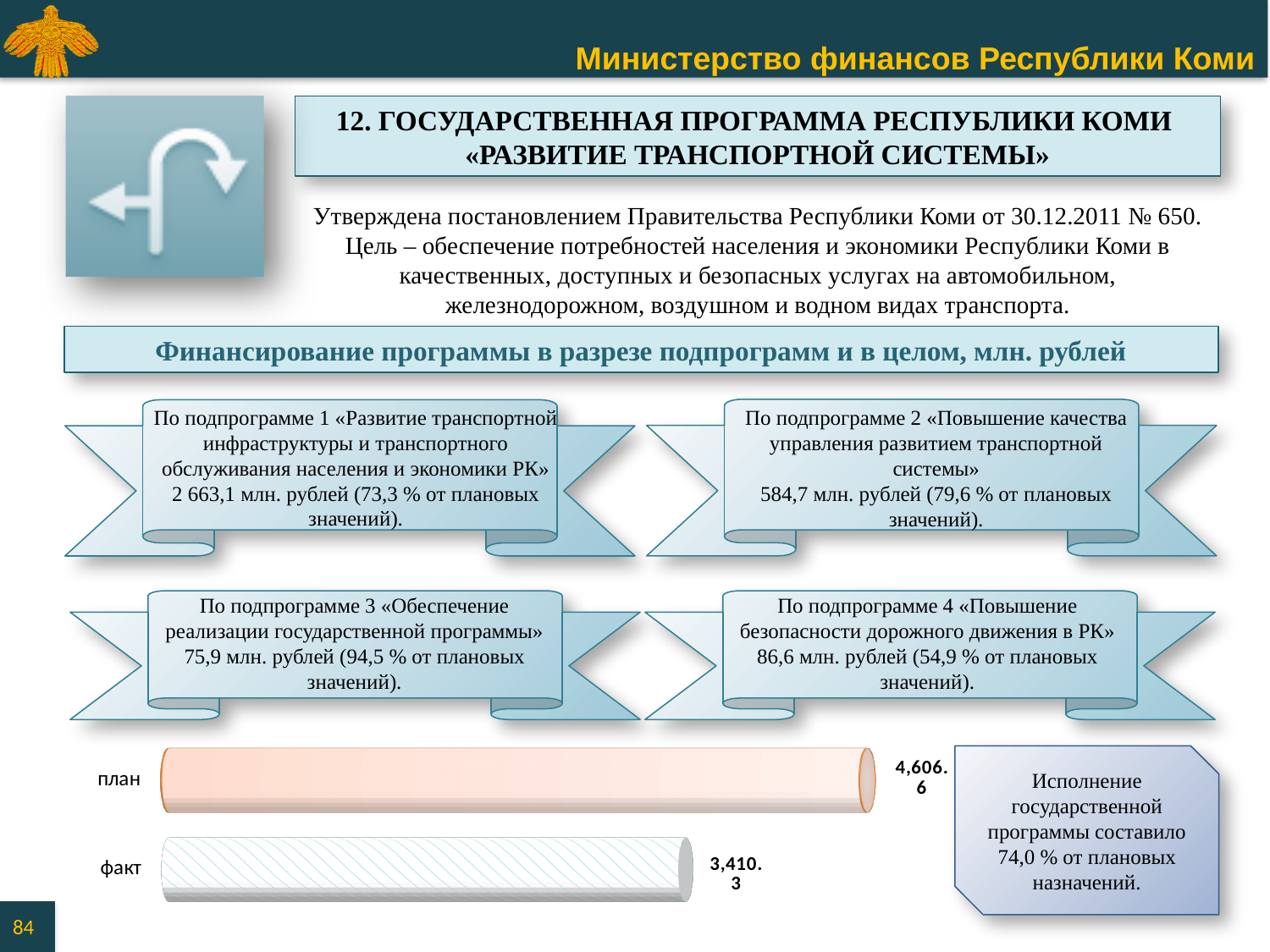
Which category has the smaller bar in the chart, план or факт? факт What is the value of the план bar in the chart at the bottom of the slide? 4,606.6 Which category has the larger bar in the chart, план or факт? план How many bars are plotted in the chart at the bottom of the slide? 2 What is the difference between the план and факт values shown in the chart? 1,196.3 What is the value of the факт bar in the chart at the bottom of the slide? 3,410.3 Is the факт value larger or smaller than the план value in the chart? smaller Which bar in the chart has a hatched (striped) pattern, план or факт? факт Are the bars in the chart oriented horizontally or vertically? horizontally What kind of chart is shown at the bottom of the slide? bar chart